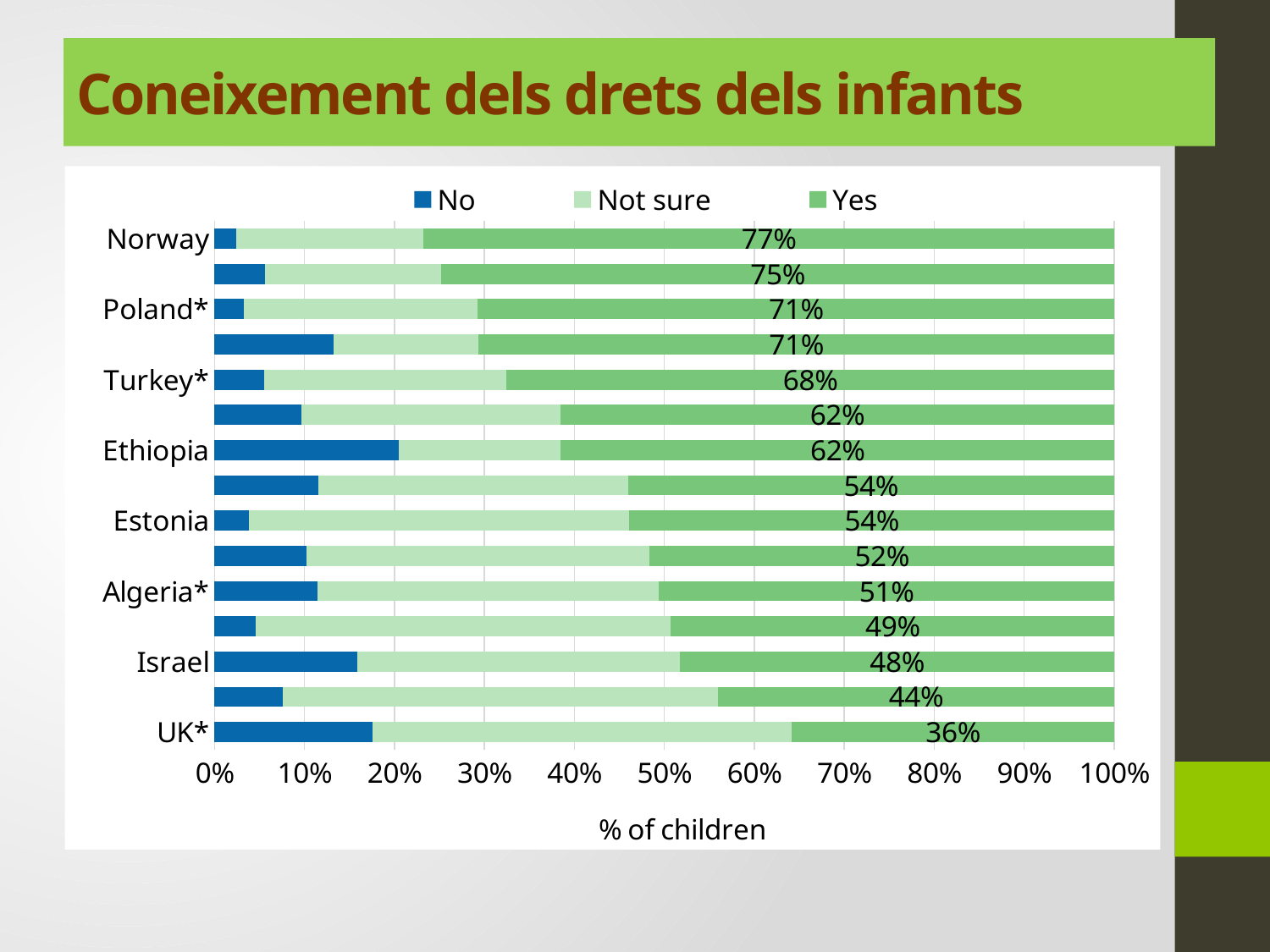
Which labelled country has the lowest "Yes" value? UK* What kind of chart is shown on the slide? Stacked bar chart What is the "Yes" value for Algeria*? 51% What is the difference between the "Yes" values for Norway and UK*? 41% What is the "Yes" value for Norway? 77% How many series does the legend list? 3 What is the "Yes" value for UK*? 36% Which labelled country has the highest "Yes" value? Norway Is the "No" value for UK* greater or less than 10%? greater Is the "No" value for Norway greater or less than 10%? less What is the "Yes" value for Ethiopia? 62% Which has a larger "Yes" value, Turkey* or Israel? Turkey*